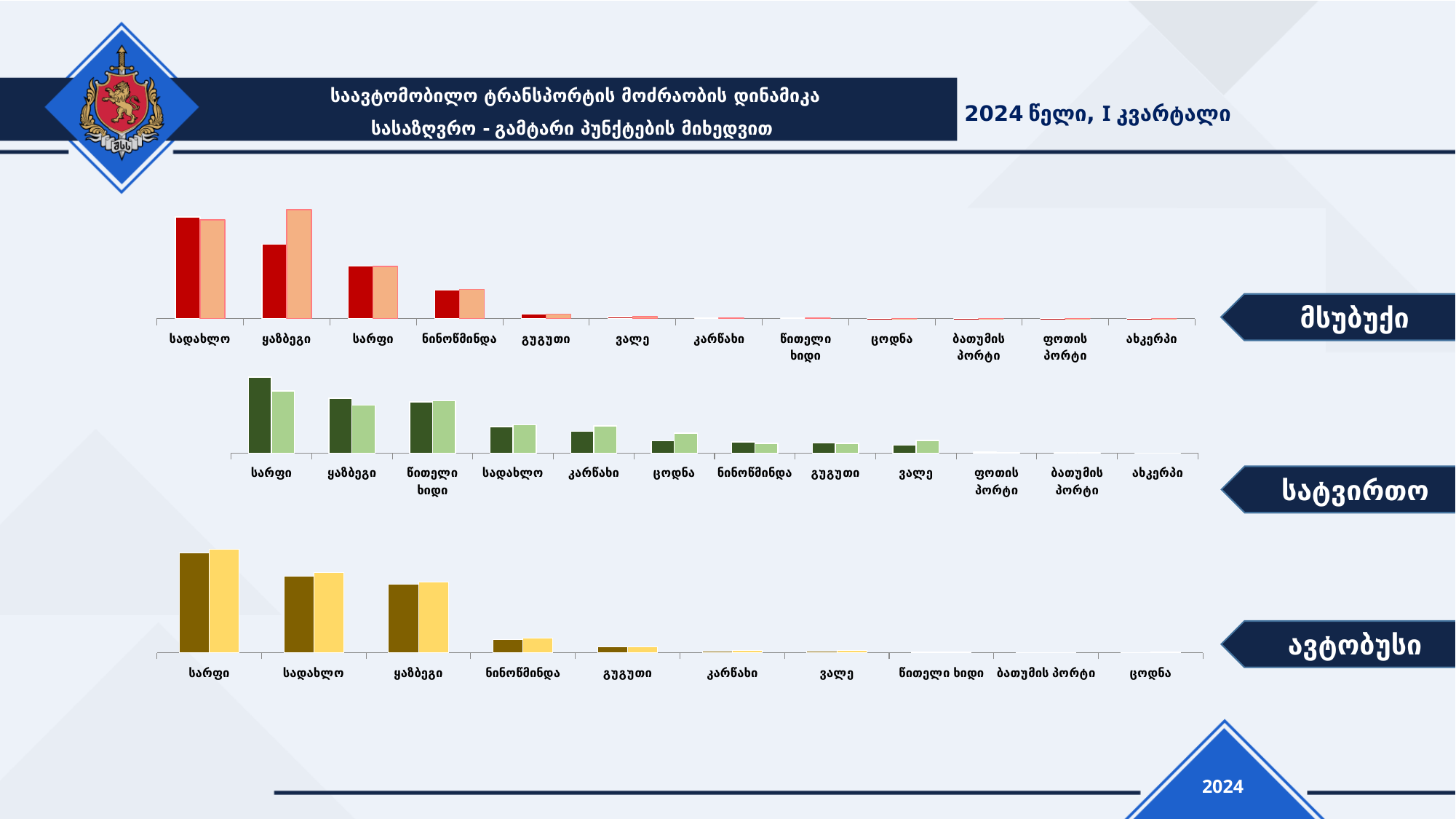
In the middle chart (სატვირთო), which category has the tallest bars? სარფი What period is stated in the header of the slide? 2024 წელი, I კვარტალი In the middle chart (სატვირთო), do the bar heights generally rise or fall from left to right along the x axis? fall What kind of chart is the top chart labelled მსუბუქი? bar chart How many categories are shown on the x axis of the top chart (მსუბუქი)? 12 How many categories are shown on the x axis of the bottom chart (ავტობუსი)? 10 In the bottom chart (ავტობუსი), which has the larger bars, სარფი or ნინოწმინდა? სარფი In the top chart (მსუბუქი), which category has the tallest light orange bar? ყაზბეგი How many categories are shown on the x axis of the middle chart (სატვირთო)? 12 In the top chart (მსუბუქი), which has the larger dark red bar, სადახლო or ყაზბეგი? სადახლო In the bottom chart (ავტობუსი), which category has the tallest bars? სარფი